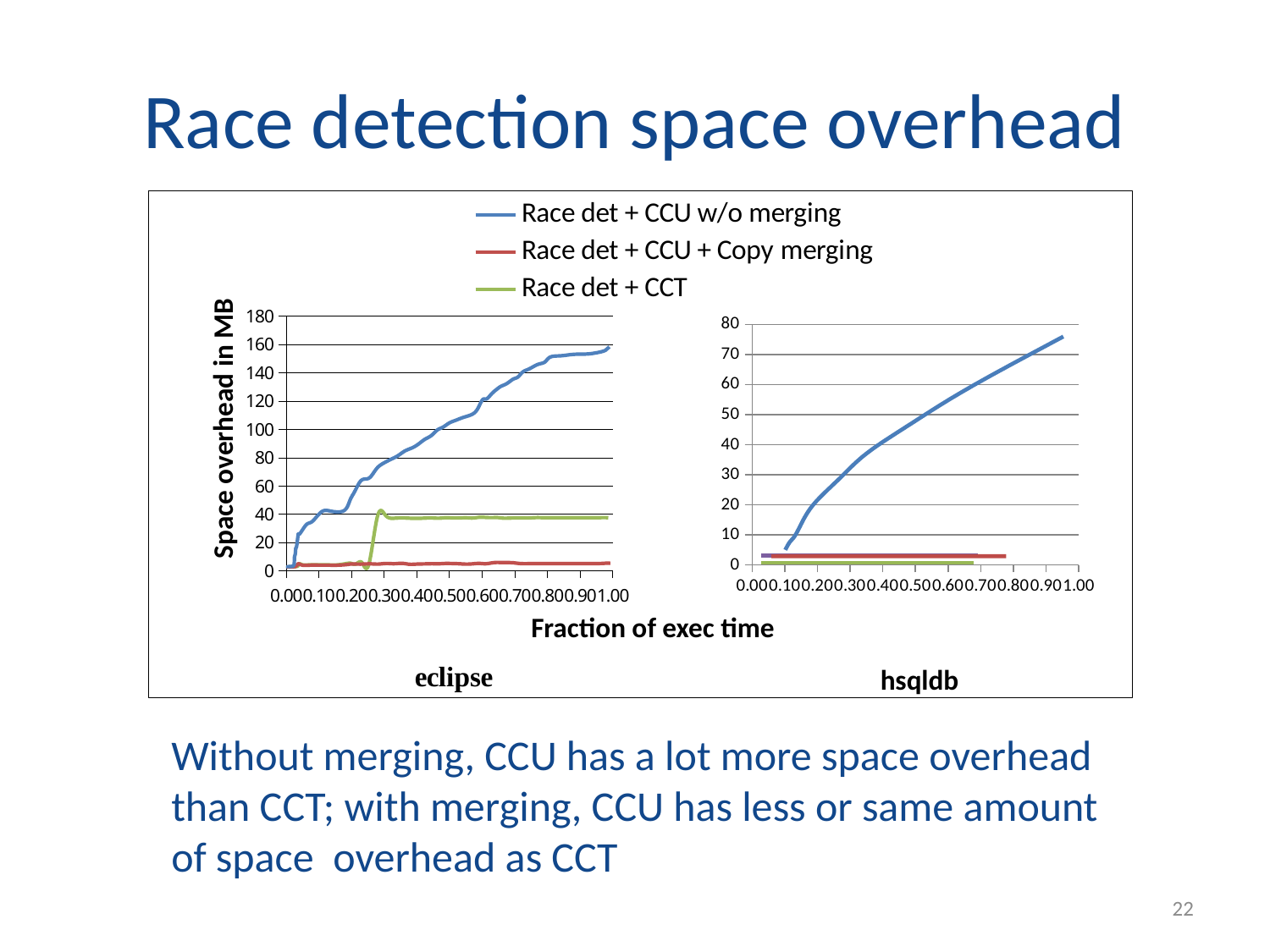
In the eclipse chart, at a fraction of exec time of 0.60, which is larger: Race det + CCU w/o merging or Race det + CCT? Race det + CCU w/o merging What kind of chart is the eclipse chart? line chart In the eclipse chart, which series has the lowest space overhead at a fraction of exec time of 0.80? Race det + CCU + Copy merging In the hsqldb chart, does the Race det + CCU w/o merging line rise or fall as the fraction of exec time increases? rise In the eclipse chart, is the value for Race det + CCU w/o merging at 1.00 greater or less than 140? greater In the eclipse chart, is the value for Race det + CCT at 0.50 greater or less than 60? less What is the y-axis title of the eclipse chart? Space overhead in MB How many series does the legend list? 3 In the hsqldb chart, is the value for Race det + CCU w/o merging at 0.30 greater or less than 40? less In the eclipse chart, which series has the highest space overhead at a fraction of exec time of 1.00? Race det + CCU w/o merging What is the x-axis title shown below the charts? Fraction of exec time